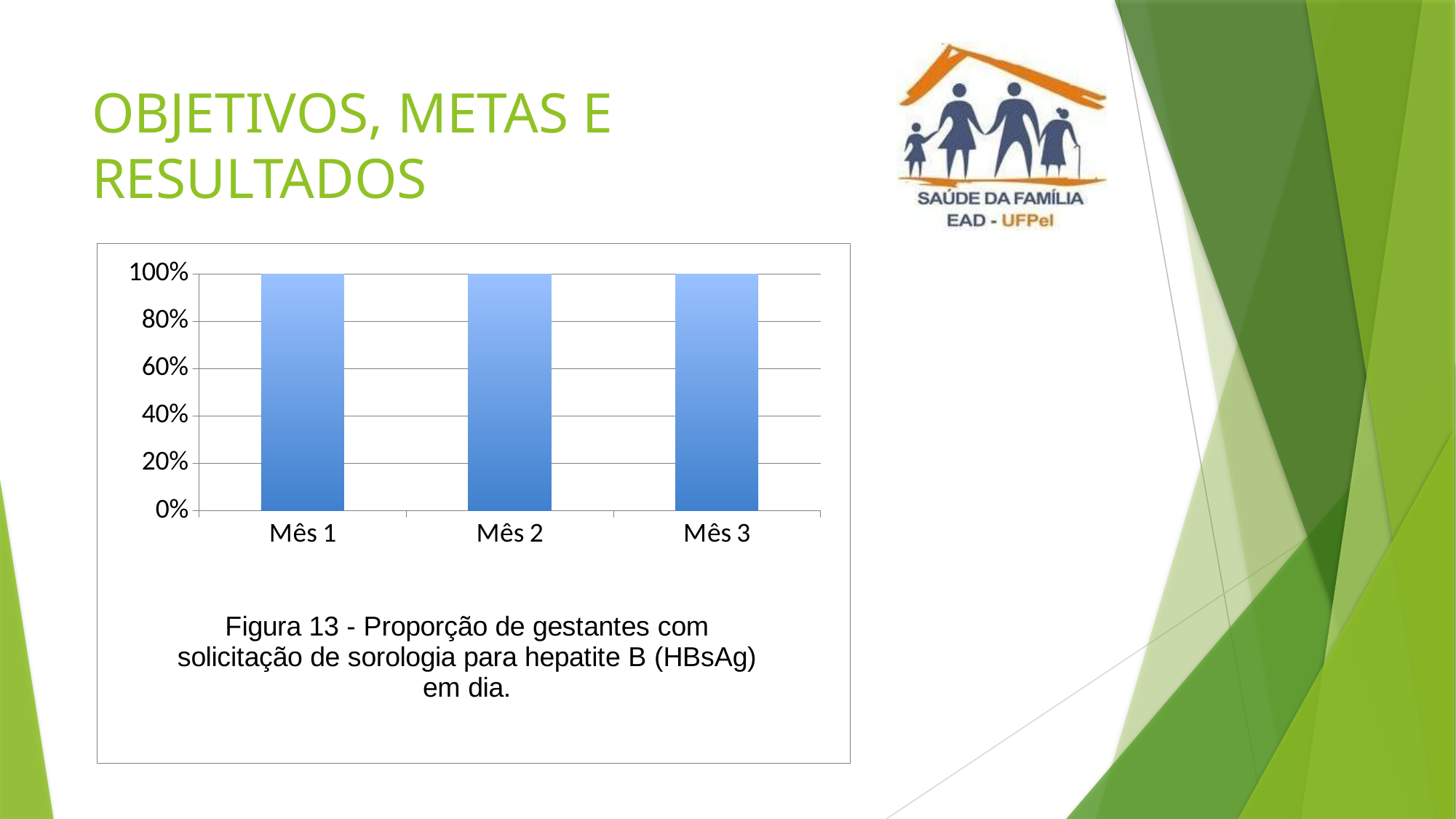
How many categories are shown on the x axis? 3 Is the value for Mês 1 larger than, smaller than, or equal to the value for Mês 2? Equal What is the difference between the values for Mês 1 and Mês 3? 0% What is the value for Mês 2? 100% What is the value for Mês 1? 100% What is the value for Mês 3? 100% Is the value for Mês 3 greater or less than 60%? greater What kind of chart is shown on the slide? Bar chart What is the highest value shown on the y axis? 100% Is the value for Mês 2 greater or less than 80%? greater What figure number is given in the chart caption? Figura 13 Do the values rise, fall, or stay the same from Mês 1 to Mês 3? Stay the same